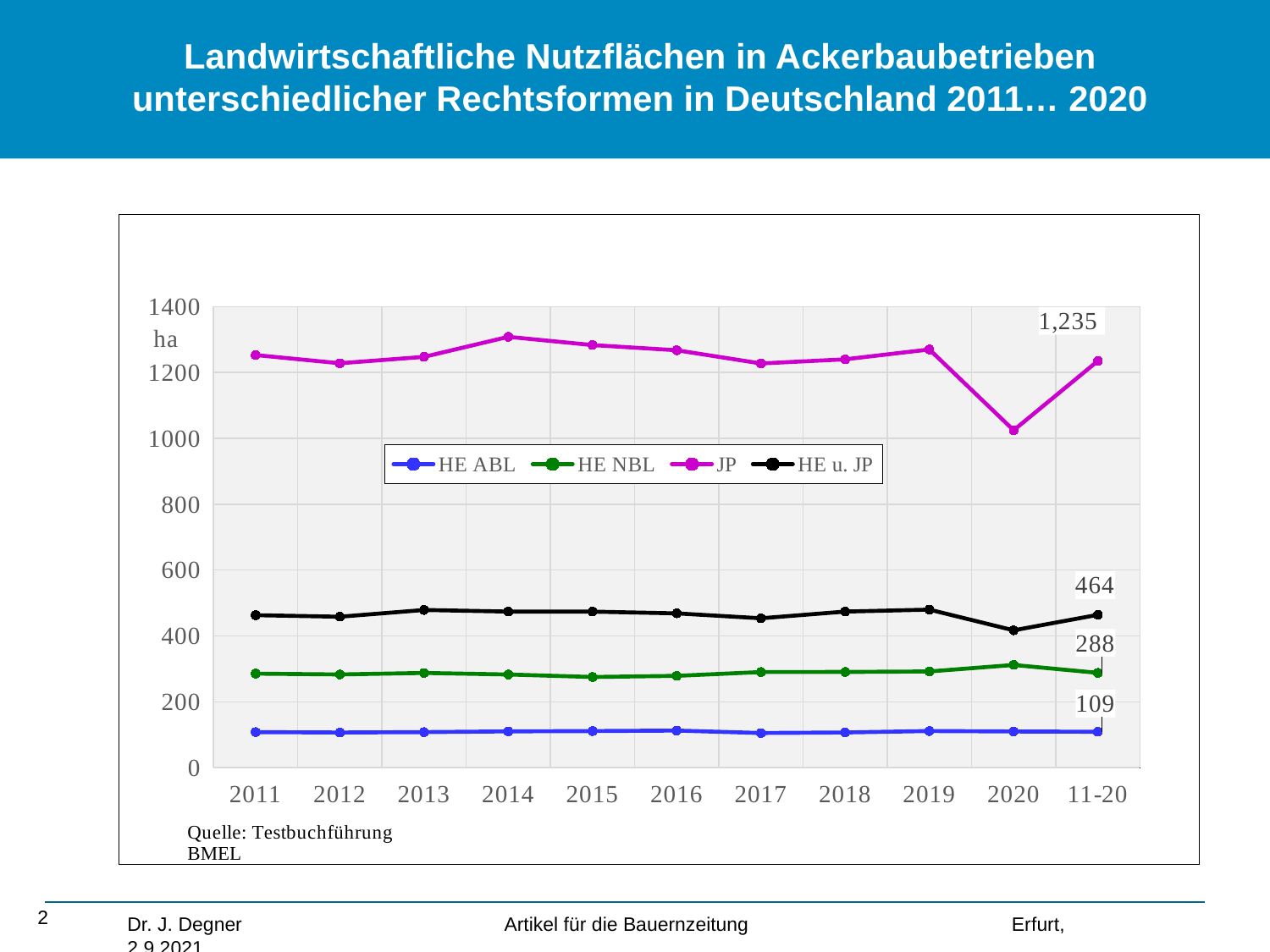
What type of chart is shown on the slide? line chart Which series has the lowest value at 11-20? HE ABL What is the value for HE u. JP at 11-20? 464 What is the difference between the JP and HE u. JP values at 11-20? 771 What is the value for HE ABL at 11-20? 109 What is the value for HE NBL at 11-20? 288 How many series does the legend list? 4 Which series has the highest value at 11-20? JP What is the value for JP at 11-20? 1,235 Is the value for HE u. JP in 2013 greater or less than 400? greater Is the value for JP in 2020 greater or less than 1200? less What unit is shown on the vertical axis? ha